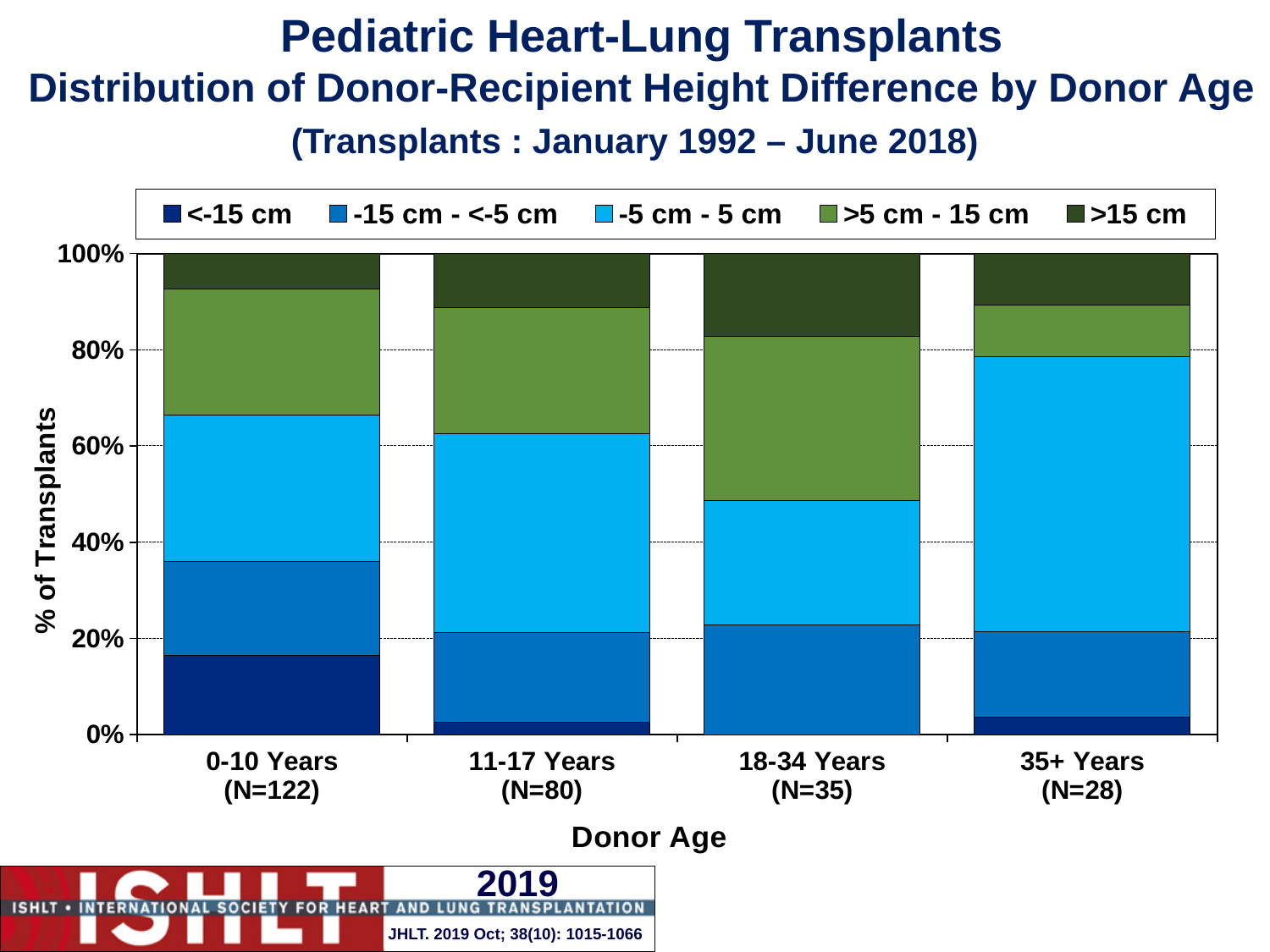
Which has the larger "<-15 cm" share: the 0-10 Years group or the 35+ Years group? 0-10 Years Which donor age group has the largest share of transplants in the ">15 cm" category? 18-34 Years How many donor age groups are shown on the x axis? 4 Is the "-5 cm - 5 cm" share for the 35+ Years donor group greater or less than 40%? greater Which donor age group has the smallest share of transplants in the "<-15 cm" category? 18-34 Years What kind of chart is shown on the slide? Stacked bar chart Is the "<-15 cm" share for the 0-10 Years donor group greater or less than 20%? less What is the N shown for the 0-10 Years donor age group? N=122 How many height-difference categories does the legend list? 5 Which donor age group has the largest share of transplants in the ">5 cm - 15 cm" category? 18-34 Years Which donor age group has the largest share of transplants in the "-5 cm - 5 cm" category? 35+ Years